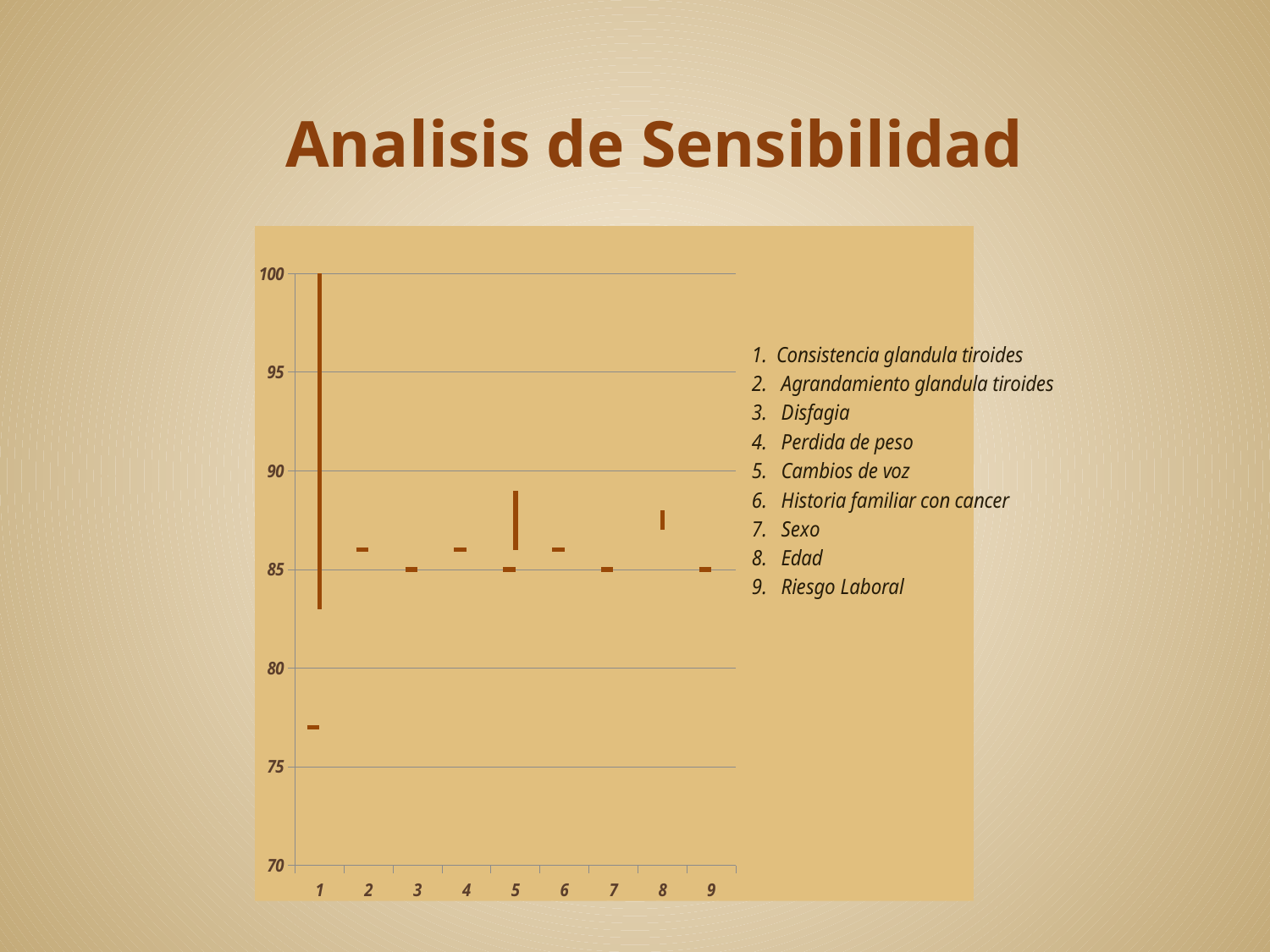
Is the value for category 3 greater or less than 90? less Is the top of the bar for category 5 greater or less than 90? less Which category has the widest range of values on the chart? 1 Which category on the x axis reaches the highest value on the chart? 1 How many numbered categories are shown along the x axis of the chart? 9 Is the value for category 7 greater or less than 80? greater According to the list next to the chart, what does category 9 represent? Riesgo Laboral What is the title of the slide containing the chart? Analisis de Sensibilidad What is the lowest value shown on the y axis of the chart? 70 What kind of chart is shown on the slide? stock chart